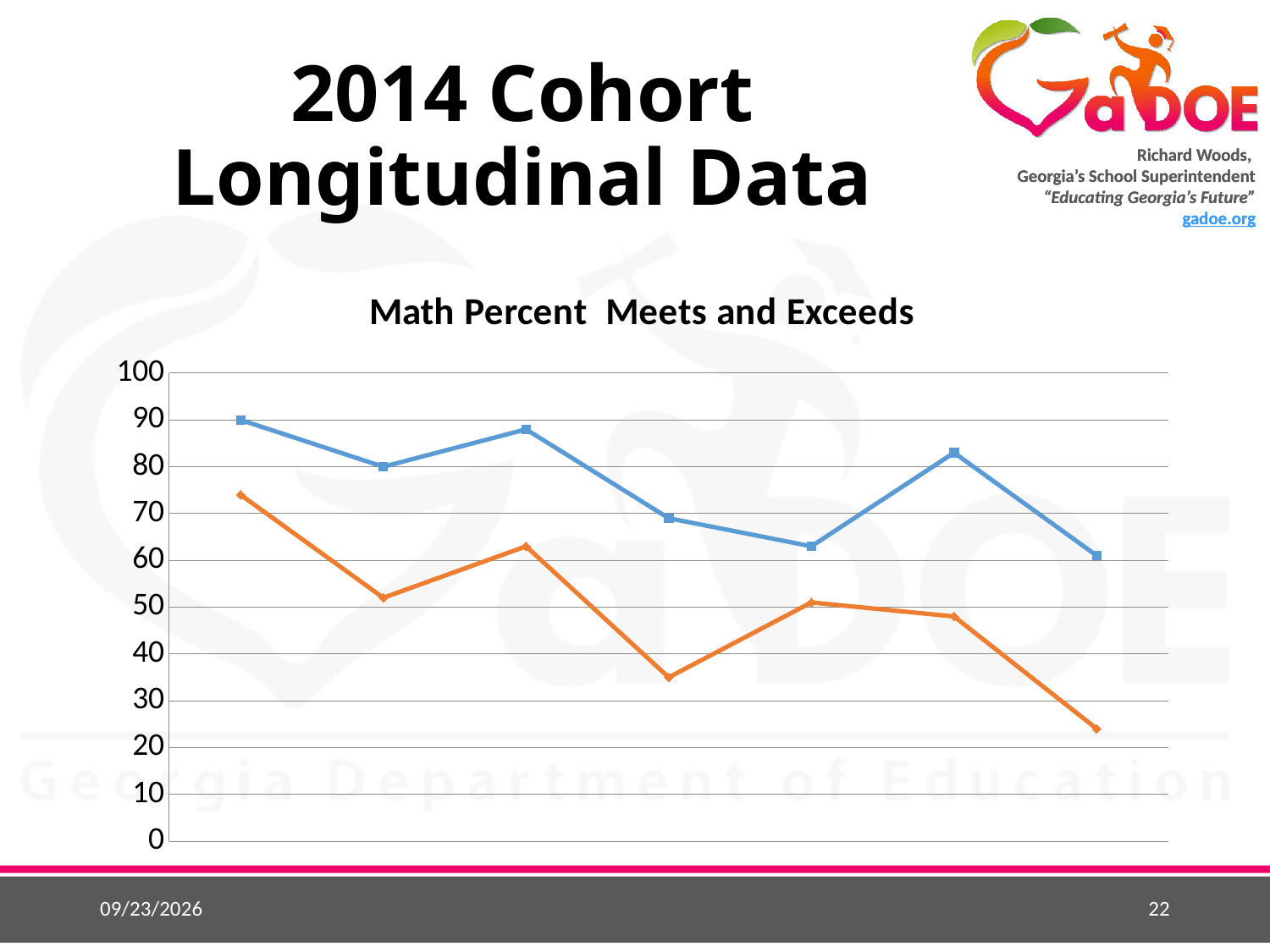
Which point of the orange line is the lowest? the last point What is the title of the chart? Math Percent Meets and Exceeds How many lines are plotted on the chart? 2 What kind of chart is shown on the slide? line chart Is the first point of the blue line greater or less than 80? greater Overall, do the values of the orange line rise or fall from left to right? fall At the first point, which line is higher, the blue line or the orange line? the blue line How many data points does each line have? 7 Is the last point of the blue line greater or less than 70? less Is the last point of the orange line greater or less than 30? less Which point of the blue line is the highest? the first point